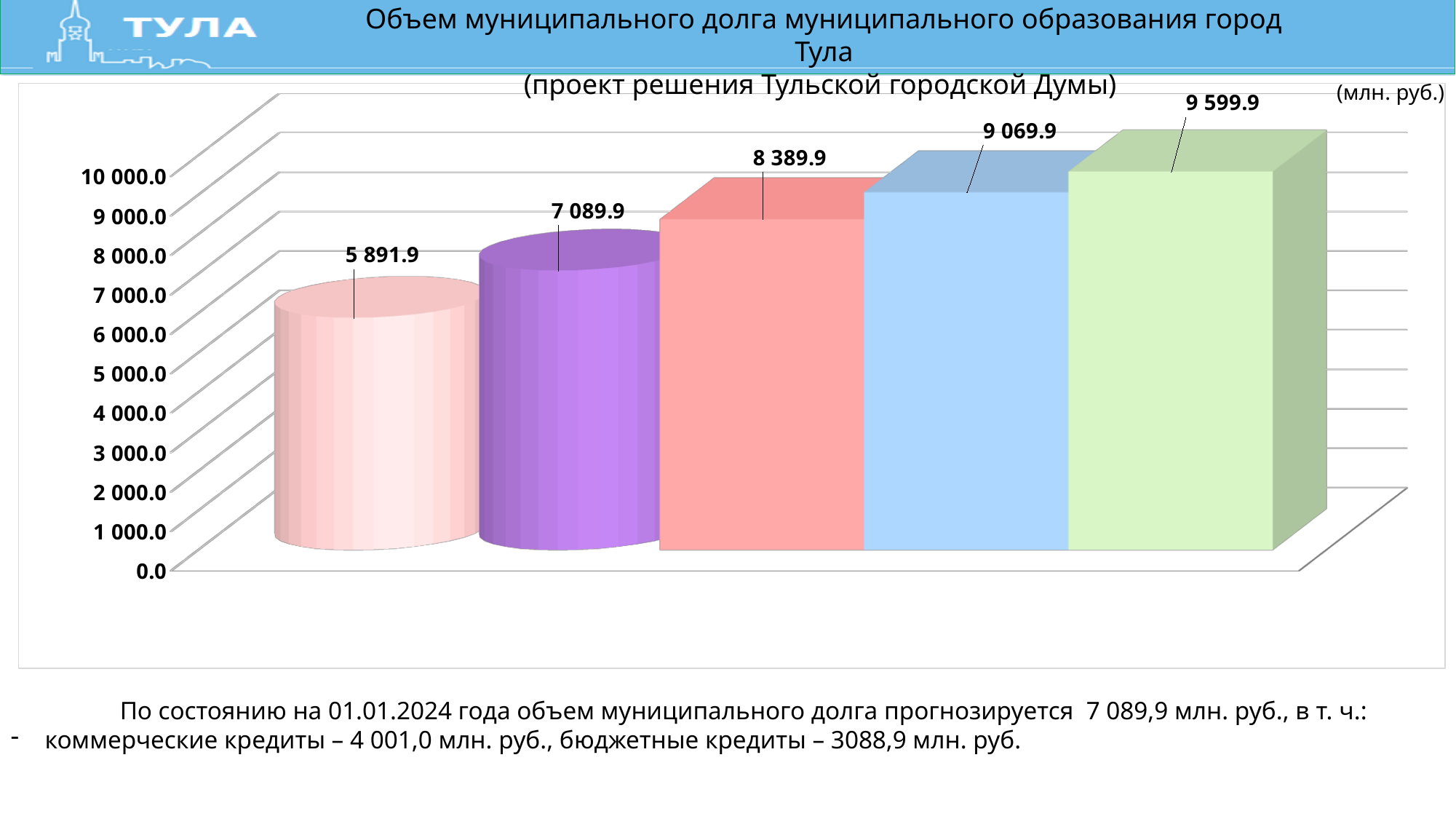
What is the value shown on the data label of the fourth (blue) bar? 9 069.9 Do the values rise or fall from left to right across the chart? Rise Which bar has the lowest value? The first (leftmost, pink) bar, 5 891.9 What kind of chart is shown on the slide? Bar chart How many bars are plotted on the chart? 5 What is the difference between the values of the fifth (green) bar and the first (pink) bar? 3 708.0 What is the value shown on the data label of the second (purple) bar? 7 089.9 What is the value shown on the data label of the first (leftmost, pink) bar? 5 891.9 What is the value shown on the data label of the third (red) bar? 8 389.9 Which bar has the highest value? The fifth (rightmost, green) bar, 9 599.9 What is the value shown on the data label of the fifth (rightmost, green) bar? 9 599.9 Which is larger: the value of the second (purple) bar or the third (red) bar? The third (red) bar, 8 389.9